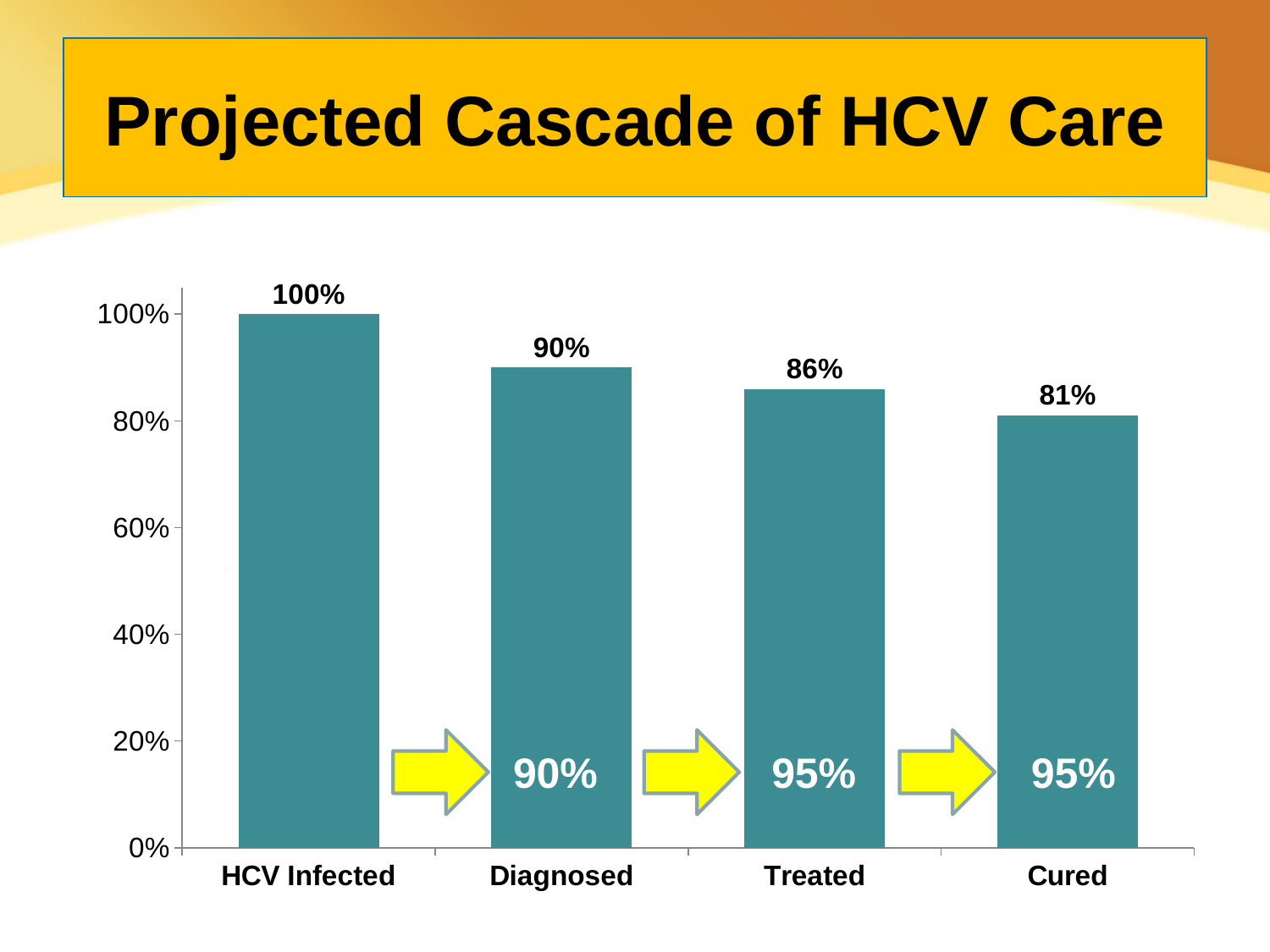
What is the value for Treated? 86% What is the difference between the values for Diagnosed and Cured? 9% What is the difference between the values for HCV Infected and Treated? 14% What kind of chart is shown on the slide? Bar chart Which category has the lowest value? Cured Which is larger, the value for Treated or the value for Cured? Treated What is the value for Cured? 81% How many categories are shown on the x axis? 4 What is the value for Diagnosed? 90% Do the values rise or fall from left to right along the x axis? Fall Which category has the highest value? HCV Infected What is the value for HCV Infected? 100%